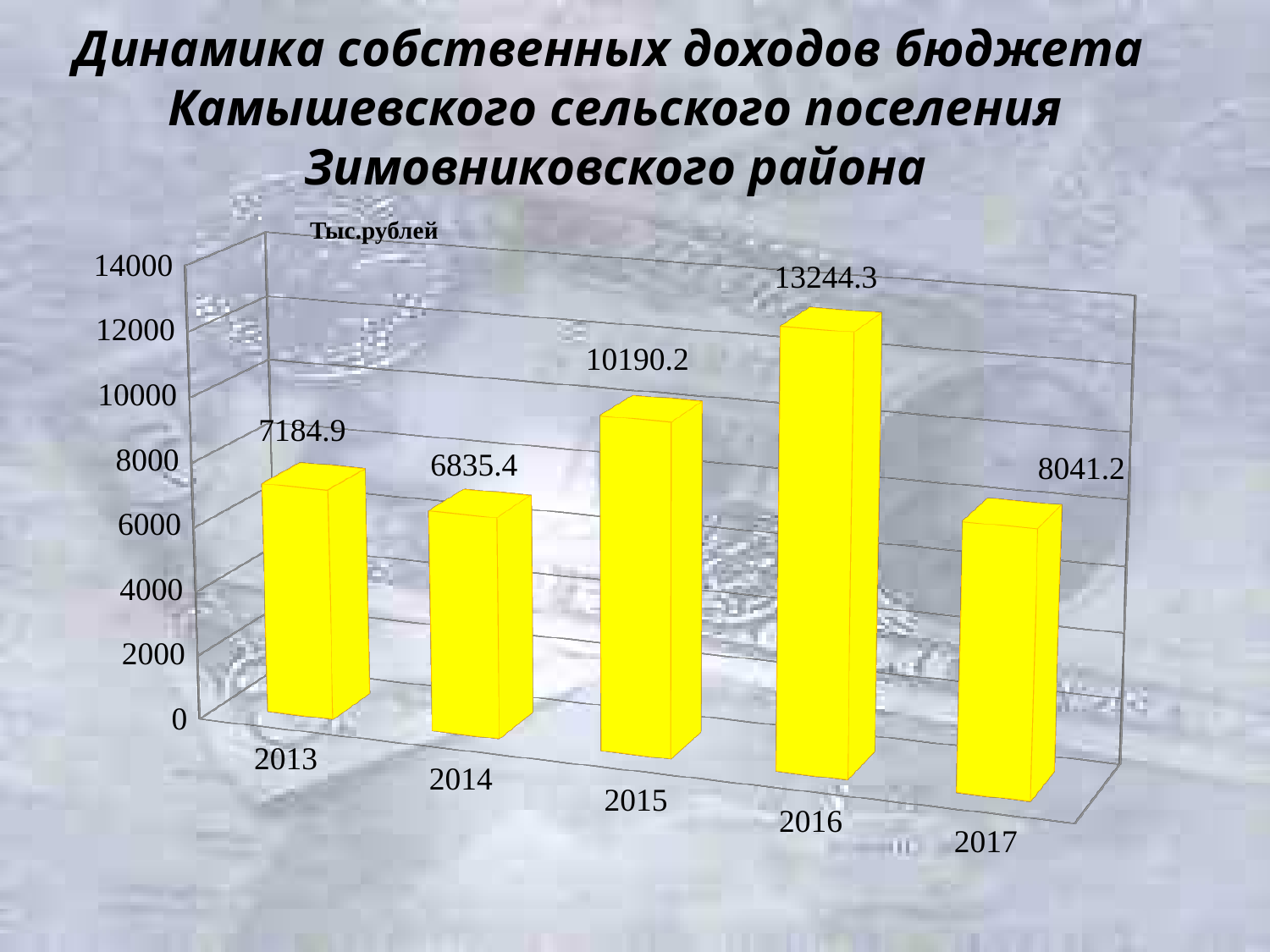
What is the value for 2016? 13244.3 What is the difference between the values for 2016 and 2015? 3054.1 What kind of chart is shown on the slide? bar chart Which year has the lowest value? 2014 What is the value for 2017? 8041.2 Which year has the highest value? 2016 Which is larger, the value for 2015 or the value for 2017? 2015 How many years are shown on the chart? 5 What unit is indicated above the chart's vertical axis? Тыс.рублей What is the value for 2014? 6835.4 What is the difference between the values for 2013 and 2014? 349.5 Is the value for 2015 greater or less than 10000? greater